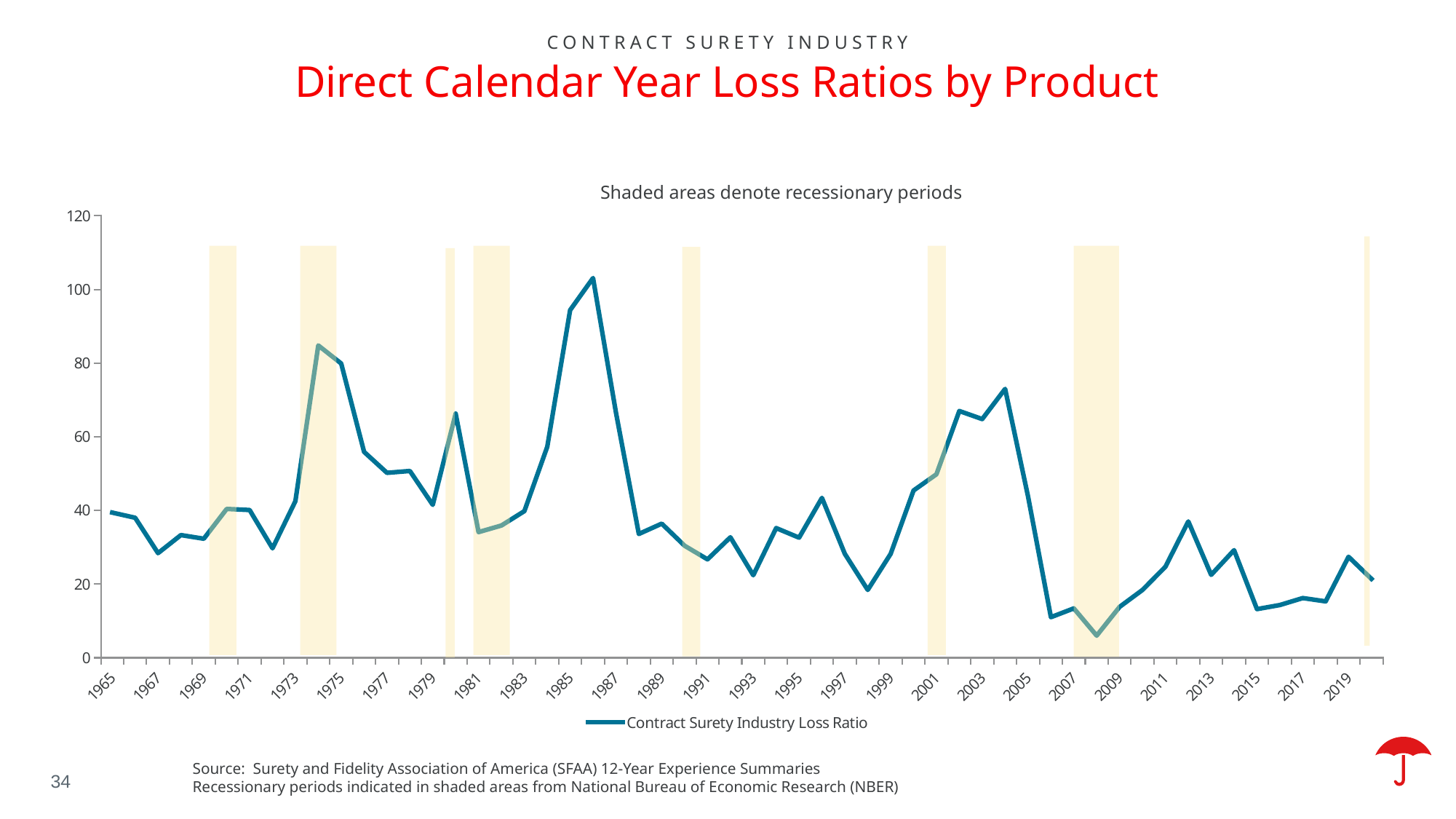
Is the loss ratio for 2008 greater or less than 20? less Is the loss ratio for 1974 greater or less than 80? greater What is the name of the series shown in the legend? Contract Surety Industry Loss Ratio In which year does the Contract Surety Industry Loss Ratio reach its highest value? 1986 Does the loss ratio rise or fall between 2004 and 2006? Fall In which year does the Contract Surety Industry Loss Ratio reach its lowest value? 2008 Which year has the higher loss ratio, 1974 or 2004? 1974 What kind of chart is shown on the slide? Line chart Is the loss ratio for 1965 greater or less than 60? less According to the note above the chart, what do the shaded areas denote? Recessionary periods How many series does the legend list? 1